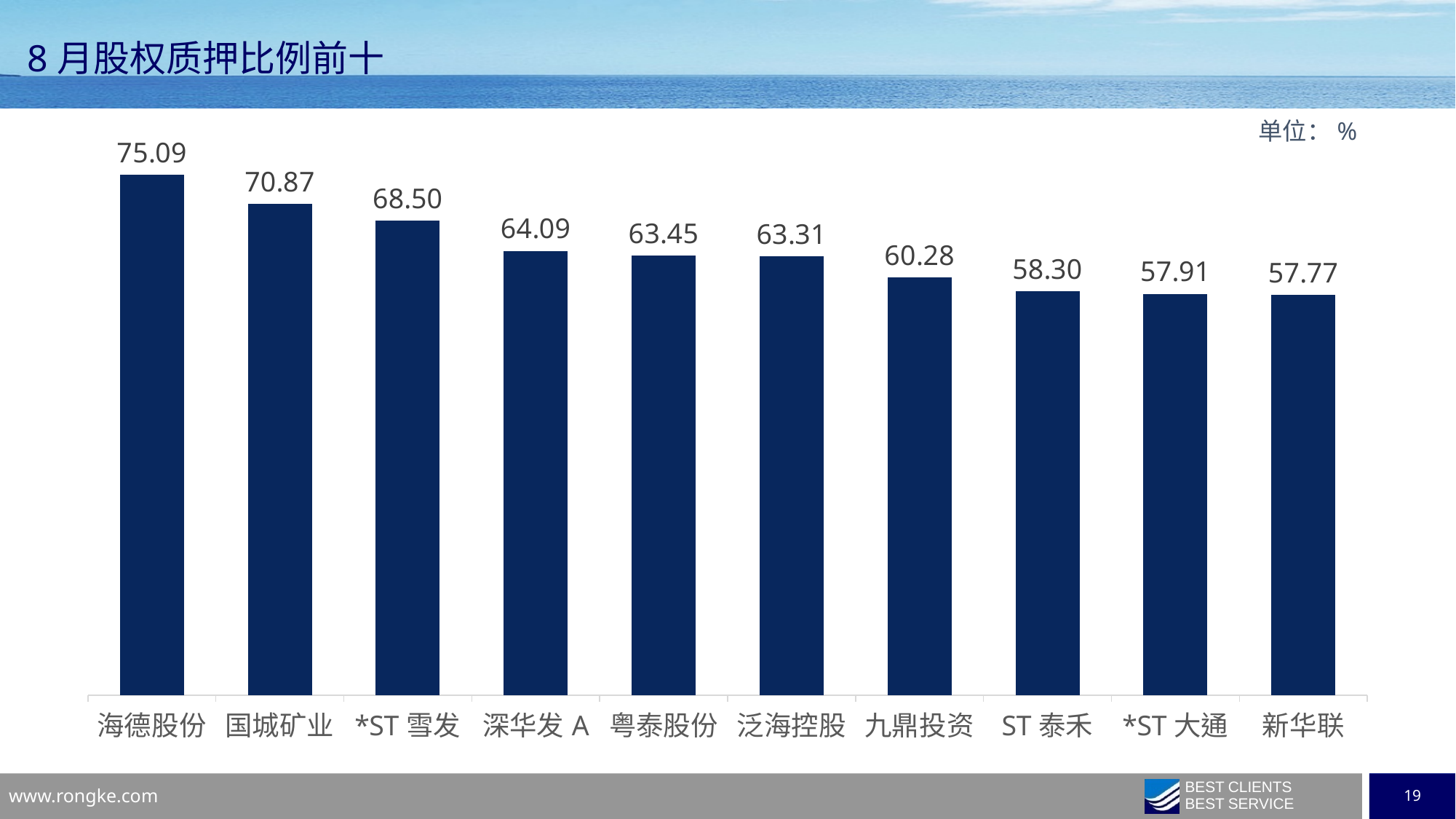
What is the difference between the values for 海德股份 and 国城矿业? 4.22 What is the title of the chart? 8 月股权质押比例前十 Which category has the highest value? 海德股份 Which category has the lowest value? 新华联 What is the value for 海德股份? 75.09 How many categories are shown in the chart? 10 What kind of chart is shown on the slide? bar chart What is the difference between the values for *ST 雪发 and 深华发 A? 4.41 What is the value for ST 泰禾? 58.30 Do the values rise or fall from left to right along the x axis? fall What is the value for 泛海控股? 63.31 Which is larger, the value for 粤泰股份 or the value for 九鼎投资? 粤泰股份